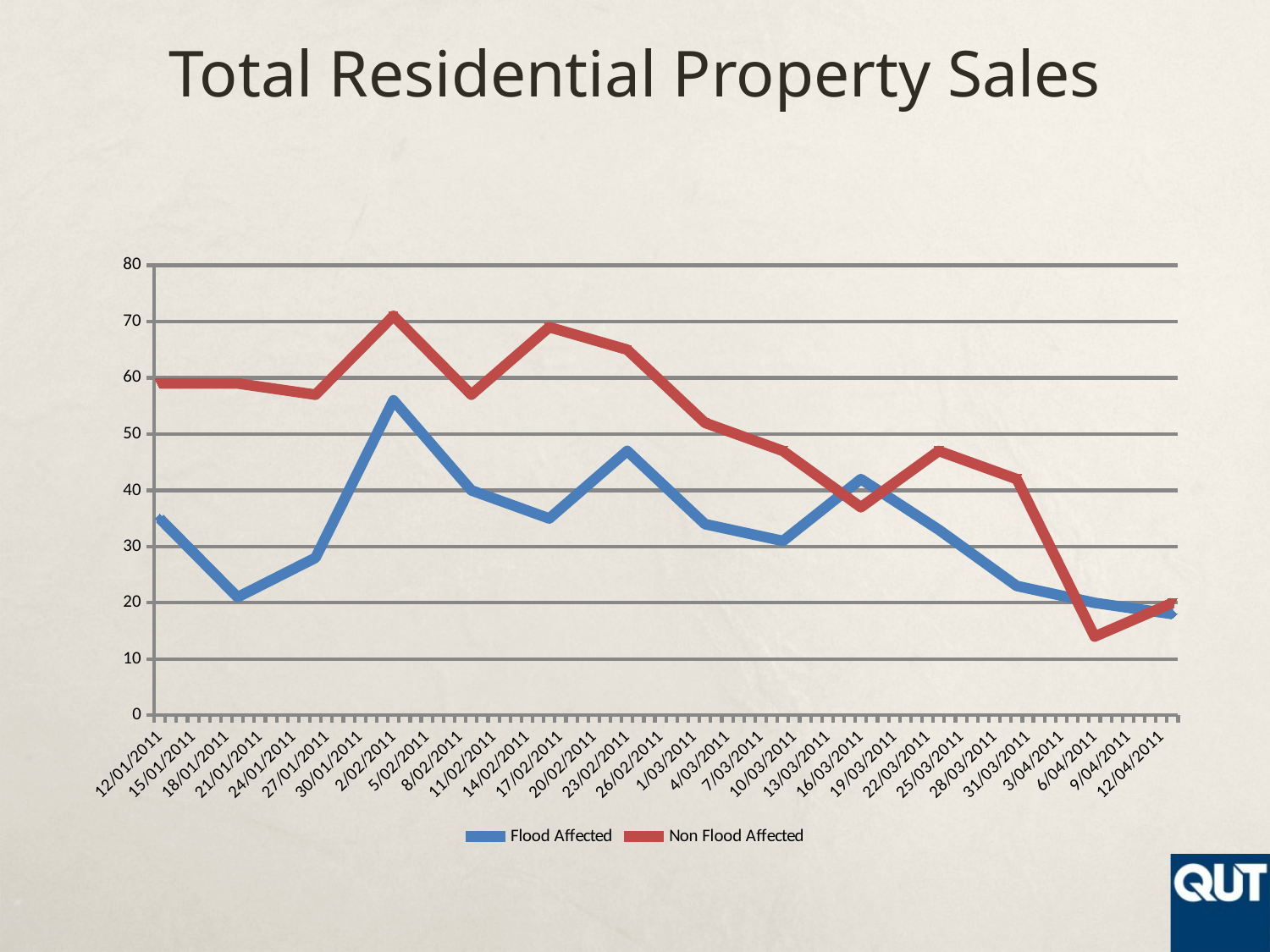
On which date does the Non Flood Affected series reach its highest value? 2/02/2011 Is the Non Flood Affected value on 6/04/2011 greater or less than 20? less Is the Flood Affected value on 12/01/2011 greater or less than 40? less Is the Non Flood Affected value on 2/02/2011 greater or less than 60? greater What is the title of the chart? Total Residential Property Sales Overall, do the Non Flood Affected values rise or fall from 12/01/2011 to 12/04/2011? fall How many series does the legend list? 2 On 12/01/2011, which series has the higher value, Flood Affected or Non Flood Affected? Non Flood Affected What kind of chart is shown on the slide? line chart On which date does the Flood Affected series reach its highest value? 2/02/2011 On which date does the Non Flood Affected series reach its lowest value? 6/04/2011 Which colour represents the Flood Affected series? blue